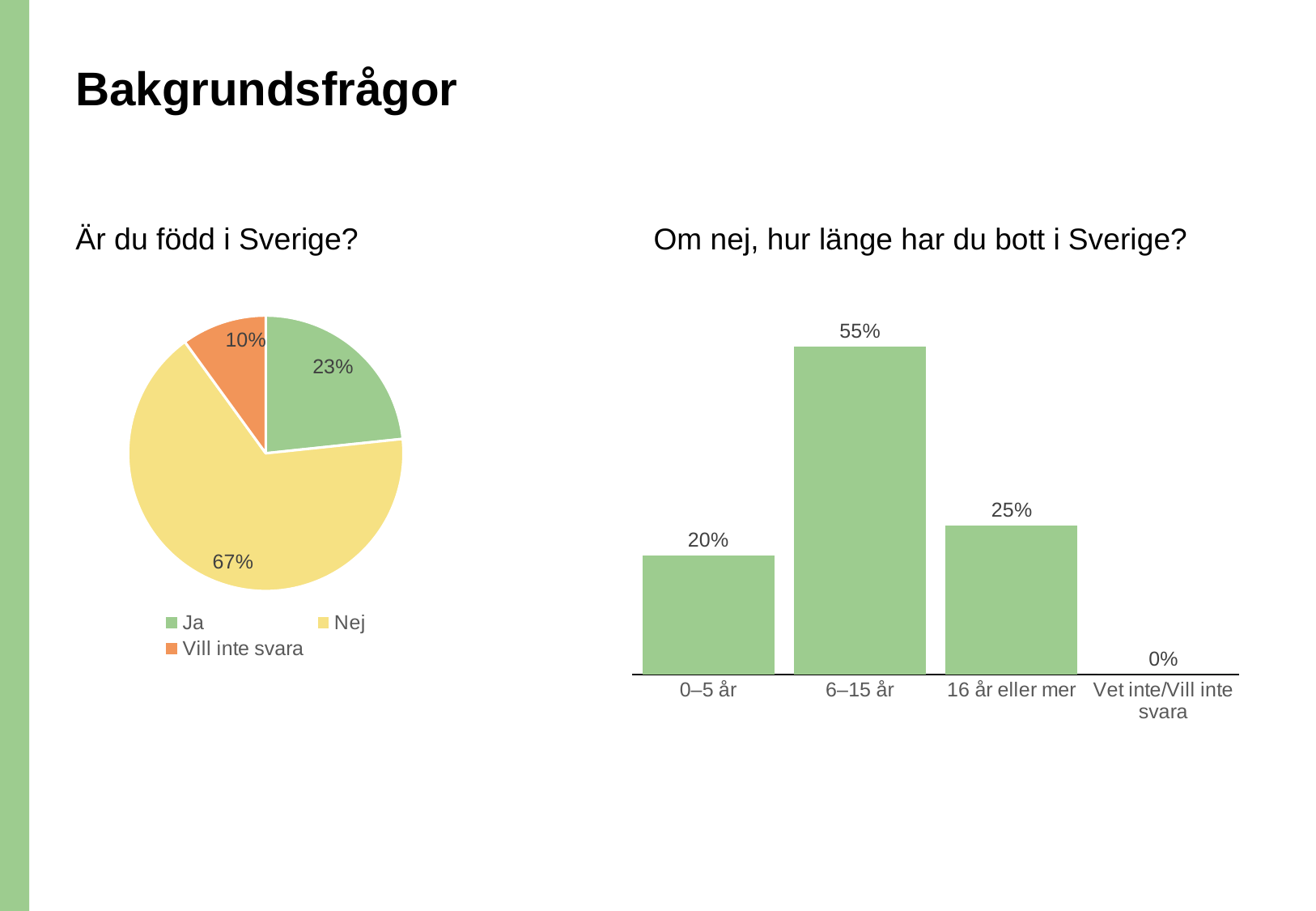
In the pie chart 'Är du född i Sverige?', what share of respondents answered 'Nej'? 67% In the bar chart 'Om nej, hur länge har du bott i Sverige?', which category has the highest value? 6–15 år In the pie chart 'Är du född i Sverige?', which answer has the smallest slice? Vill inte svara What kind of chart is the chart on the right, 'Om nej, hur länge har du bott i Sverige?'? Bar chart In the bar chart 'Om nej, hur länge har du bott i Sverige?', what is the difference between '6–15 år' and '16 år eller mer'? 30% In the pie chart 'Är du född i Sverige?', which answer has the largest slice? Nej In the pie chart 'Är du född i Sverige?', what share of respondents answered 'Ja'? 23% In the bar chart 'Om nej, hur länge har du bott i Sverige?', what is the value for '0–5 år'? 20% In the bar chart 'Om nej, hur länge har du bott i Sverige?', what is the value for '6–15 år'? 55% In the pie chart 'Är du född i Sverige?', how many slices does the pie have? 3 In the pie chart 'Är du född i Sverige?', what share is 'Vill inte svara'? 10% In the bar chart 'Om nej, hur länge har du bott i Sverige?', which is larger: '0–5 år' or '16 år eller mer'? 16 år eller mer